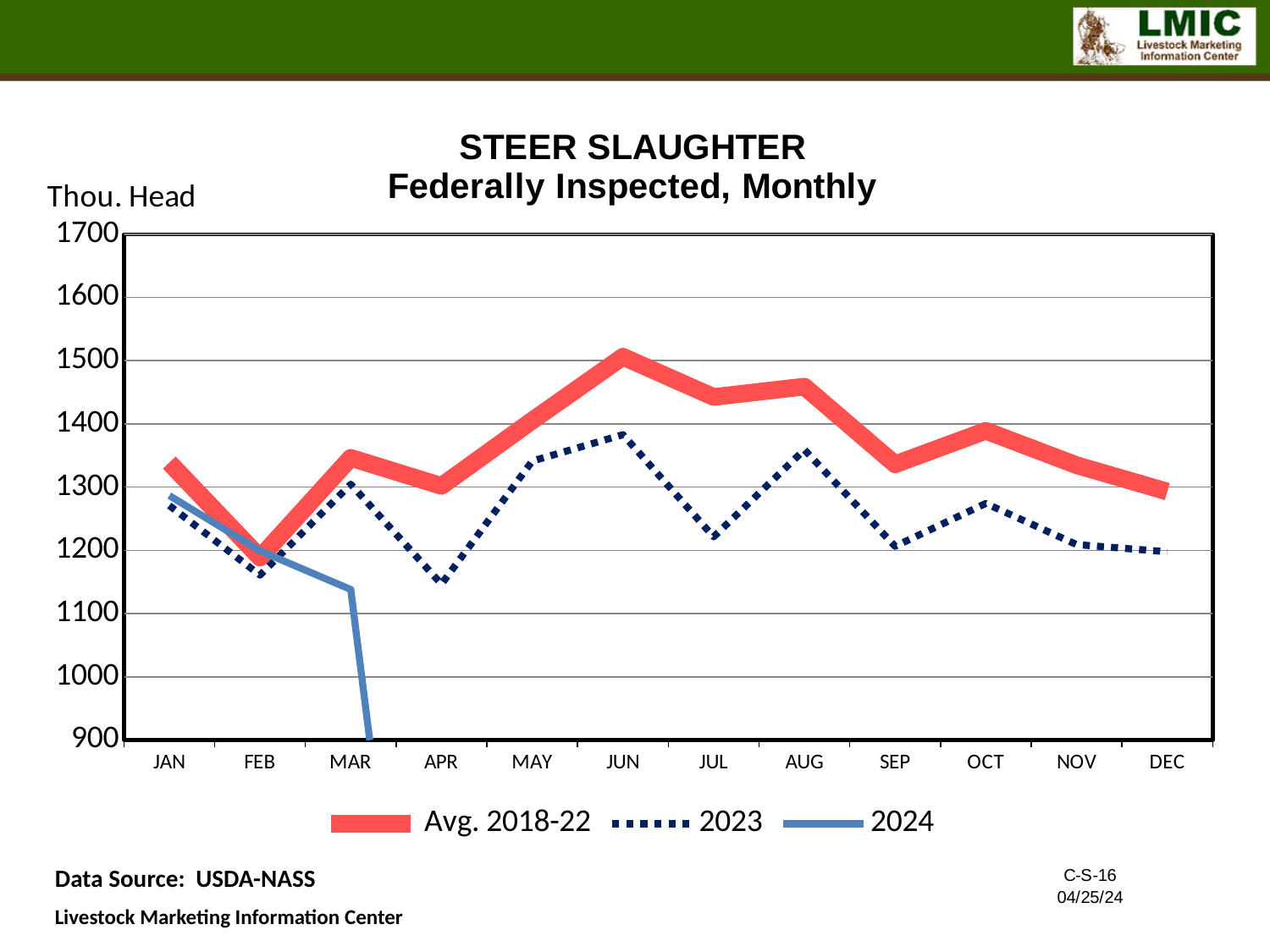
Is the 2023 value for APR greater or less than 1200? less Is the Avg. 2018-22 value for AUG greater or less than 1400? greater In which month does the 2023 series reach its lowest value? APR How many series does the legend list? 3 Does the 2024 series rise or fall from JAN to MAR? fall Which series has the larger value in JUN, Avg. 2018-22 or 2023? Avg. 2018-22 How many months are shown along the x axis? 12 In which month does the Avg. 2018-22 series reach its lowest value? FEB In which month does the Avg. 2018-22 series reach its highest value? JUN What kind of chart is shown on the slide? line chart In which month does the 2023 series reach its highest value? JUN What unit label is shown above the y axis? Thou. Head